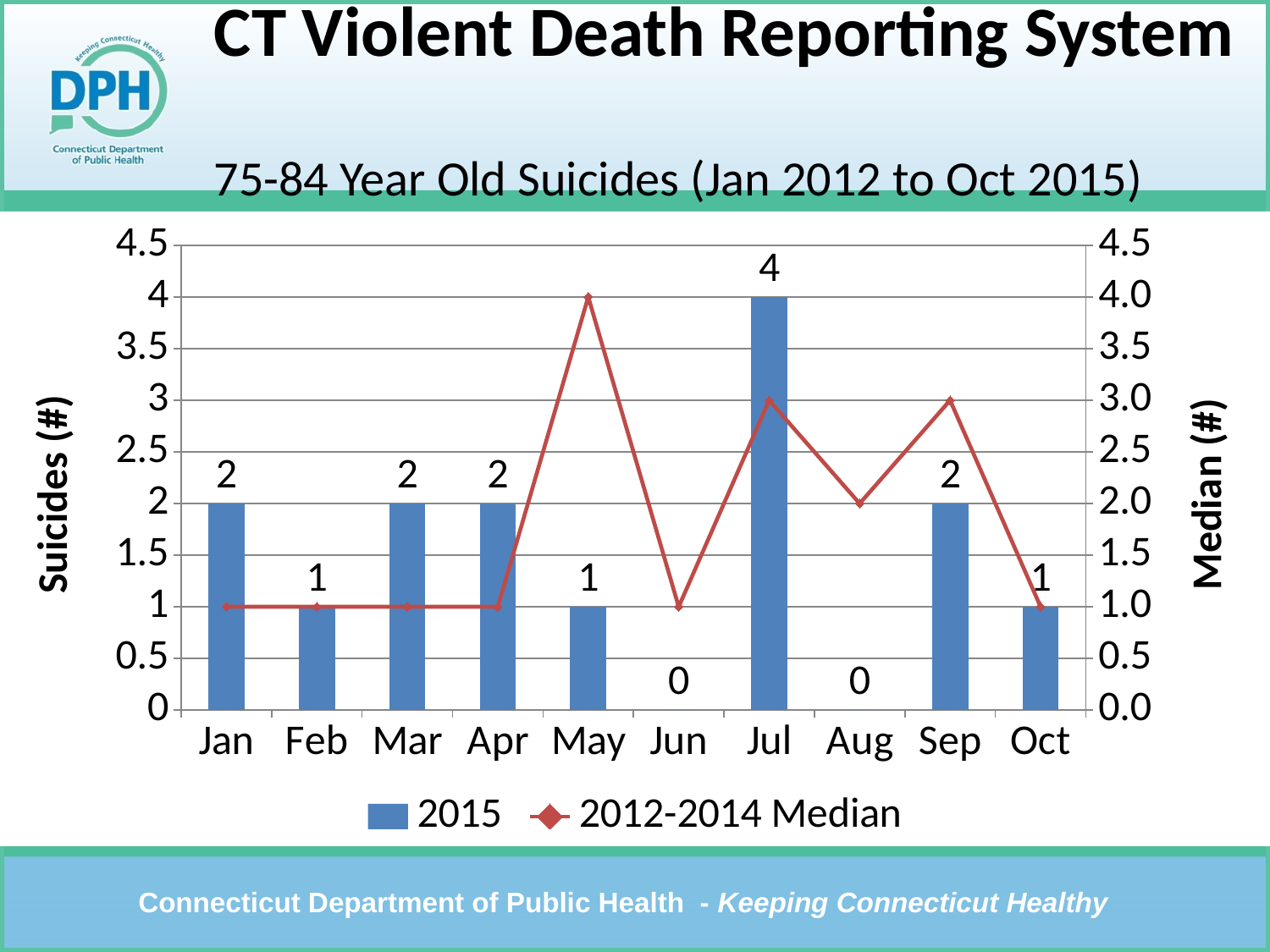
What kind of chart is used for the 2015 series? Bar chart How many series does the legend list? 2 What is the label of the right-hand vertical axis? Median (#) Which is larger, the 2015 value for Mar or the 2015 value for May? Mar Which month has the highest 2015 suicide count? Jul What is the number of suicides for Feb in the 2015 series? 1 How many months are shown on the x axis? 10 What is the number of suicides for Jul in the 2015 series? 4 What is the 2012-2014 Median value for May? 4.0 Which months have a 2015 suicide count of 0? Jun and Aug In which month does the 2012-2014 Median line reach its highest value? May What is the difference between the 2015 values for Jul and Sep? 2